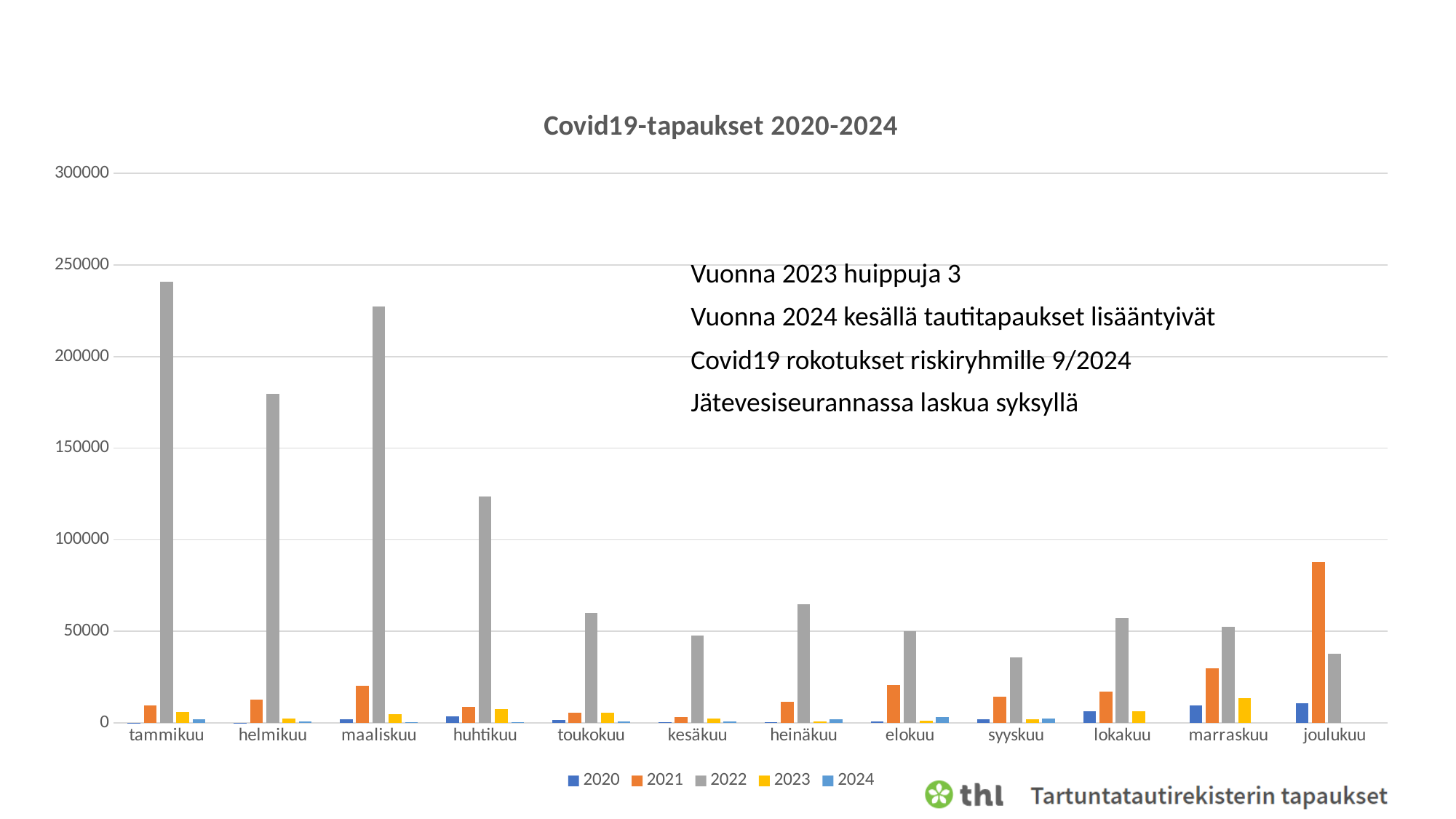
Is the 2021 value for joulukuu greater or less than 100000? less How many series does the legend list? 5 Which month has the highest value for the 2021 series? joulukuu How many months (categories) are shown on the x axis? 12 Which month has the highest value for the 2022 series? tammikuu Do the 2022 values rise or fall from maaliskuu to kesäkuu? fall In joulukuu, which series has the larger value: 2021 or 2022? 2021 Which is larger for 2022: the value for helmikuu or the value for huhtikuu? helmikuu What is the title of the chart? Covid19-tapaukset 2020-2024 Is the 2022 value for tammikuu greater or less than 200000? greater What kind of chart is shown on the slide? bar chart Is the 2022 value for huhtikuu greater or less than 100000? greater